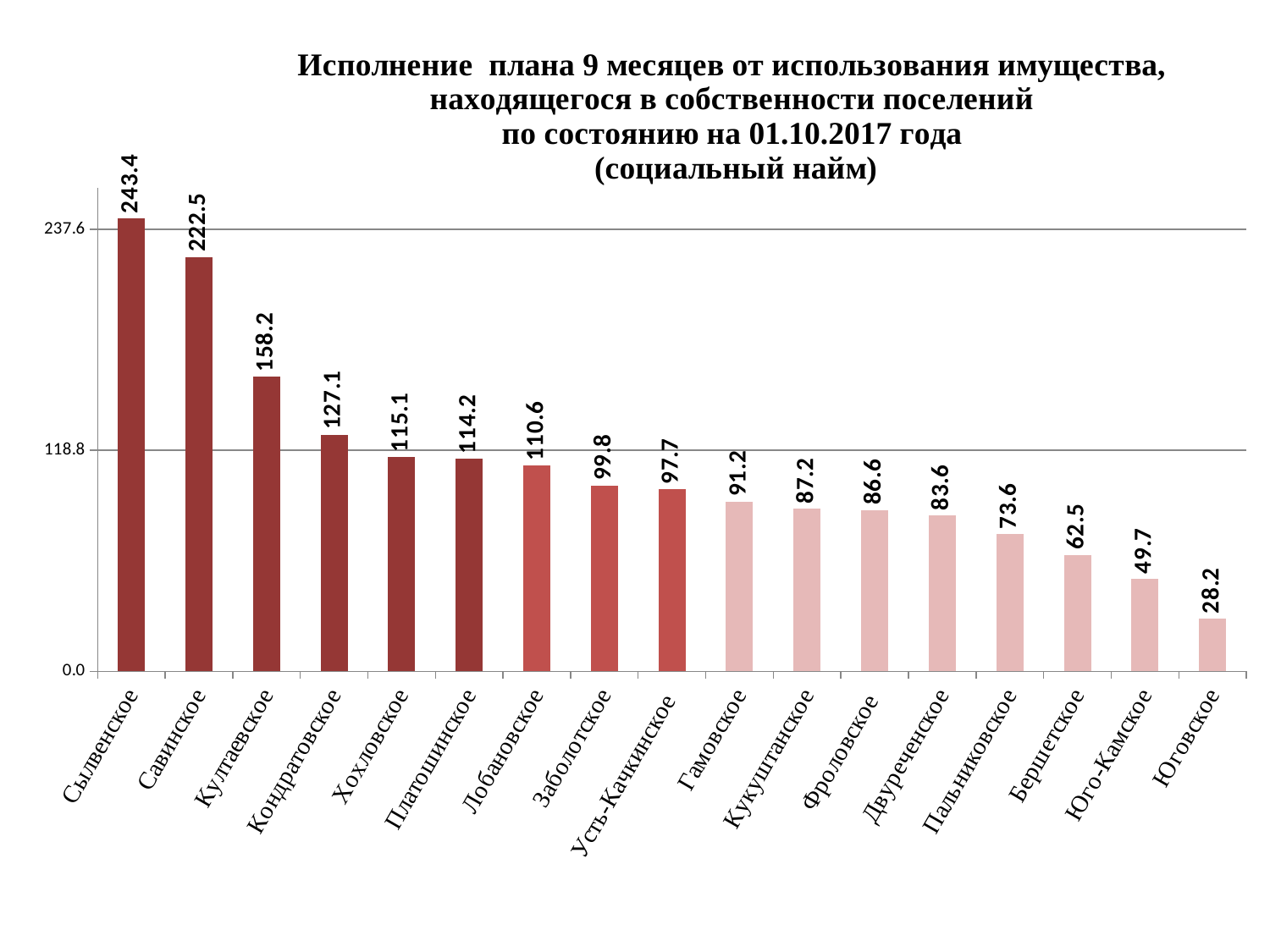
Which is larger, the value for Лобановское or the value for Гамовское? Лобановское What is the value for Юго-Камское? 49.7 What kind of chart is shown on the slide? bar chart What is the difference between the values for Култаевское and Юговское? 130.0 Which category has the highest value? Сылвенское What is the value for Сылвенское? 243.4 Which category has the lowest value? Юговское What is the value for Кондратовское? 127.1 How many categories are shown on the x axis? 17 Is the value for Пальниковское greater or less than 118.8? less Do the values rise or fall from left to right along the x axis? fall What is the difference between the values for Сылвенское and Савинское? 20.9